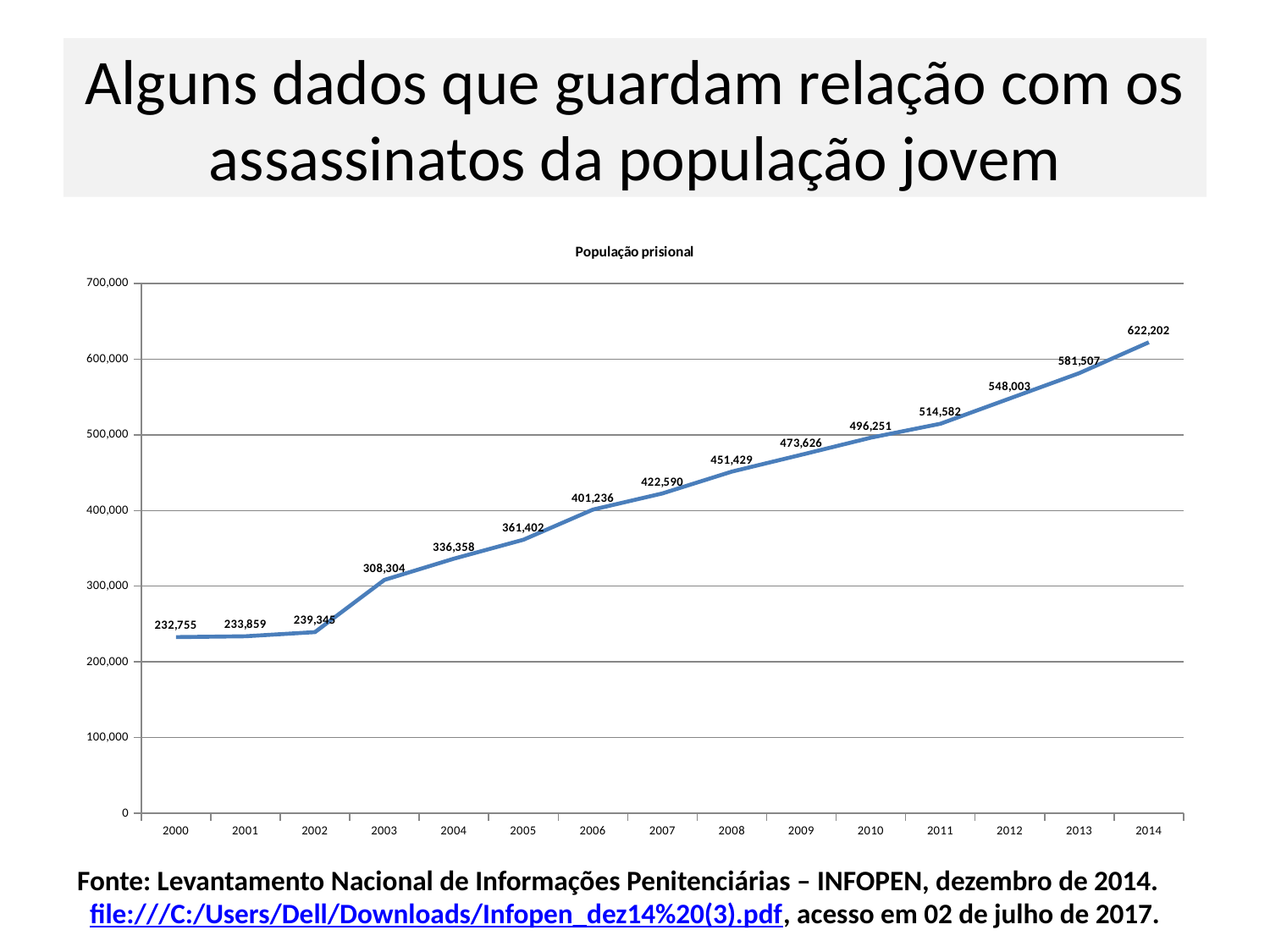
What is the title of the chart? População prisional Which year has the lowest value? 2000 What type of chart is shown on the slide? Line chart Do the values rise or fall from 2000 to 2014? Rise What is the value for 2000? 232,755 How many years are plotted on the x axis? 15 What is the value for 2010? 496,251 What is the value for 2014? 622,202 What is the value for 2006? 401,236 What is the difference between the values for 2014 and 2000? 389,447 What is the difference between the values for 2003 and 2002? 68,959 Which year has the highest value? 2014